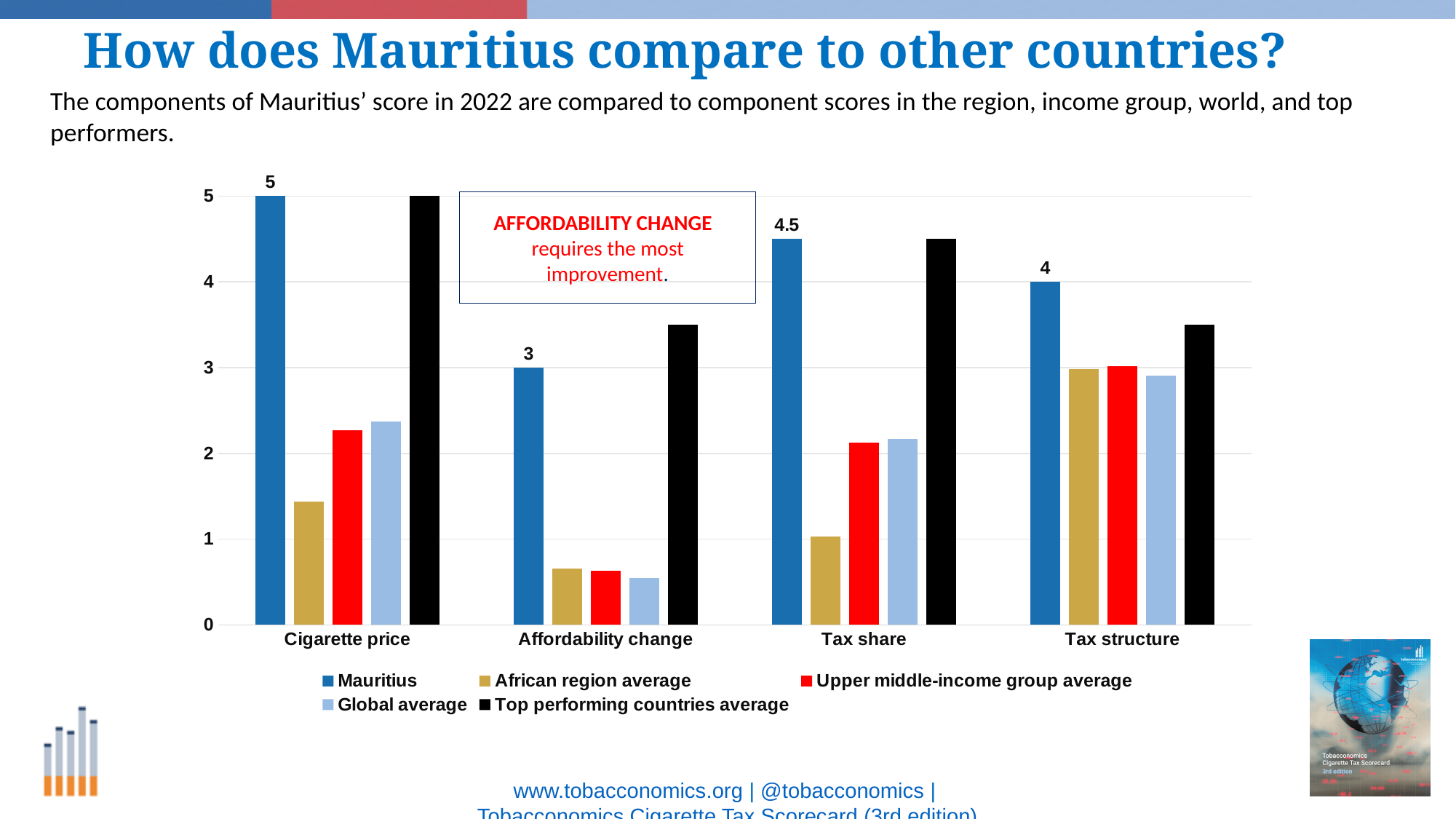
How many series does the legend list? 5 What kind of chart is shown on the slide? bar chart Is the Global average for Tax structure greater or less than 2? greater In which component does Mauritius have its lowest score? Affordability change How many components (categories) are shown on the x axis? 4 What is the Mauritius score for Cigarette price? 5 What is the Mauritius score for Tax structure? 4 What is the Mauritius score for Tax share? 4.5 In which component does Mauritius have its highest score? Cigarette price What is the difference between the Mauritius scores for Cigarette price and Affordability change? 2 Is the African region average for Cigarette price greater or less than 2? less What is the Mauritius score for Affordability change? 3